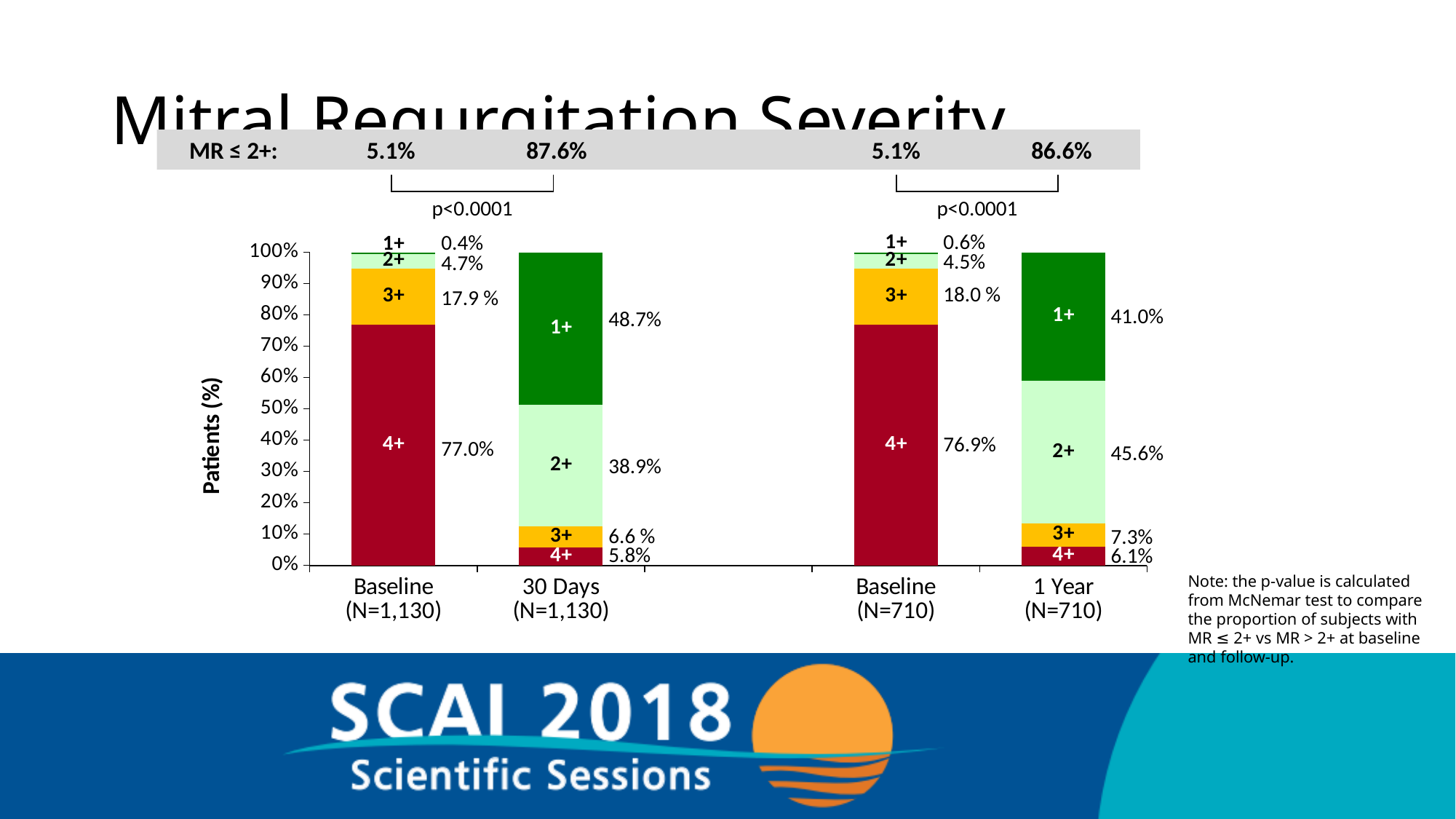
What is the label on the vertical axis of the chart? Patients (%) What is the difference between the 4+ share at Baseline (N=1,130) and the 4+ share at 30 Days? 71.2% What is the MR ≤ 2+ proportion shown for 1 Year? 86.6% Which MR grade has the smallest share of patients at Baseline (N=1,130)? 1+ Which MR grade has the largest share of patients at 30 Days? 1+ What type of chart is shown on the slide? Stacked bar chart Is the 2+ share larger at 30 Days or at 1 Year? 1 Year How many bars are plotted on the chart? 4 What percentage of patients had 3+ mitral regurgitation at Baseline (N=710)? 18.0 % What percentage of patients had 4+ mitral regurgitation at Baseline (N=1,130)? 77.0% What percentage of patients had 1+ mitral regurgitation at 30 Days? 48.7% What percentage of patients had 2+ mitral regurgitation at 1 Year (N=710)? 45.6%